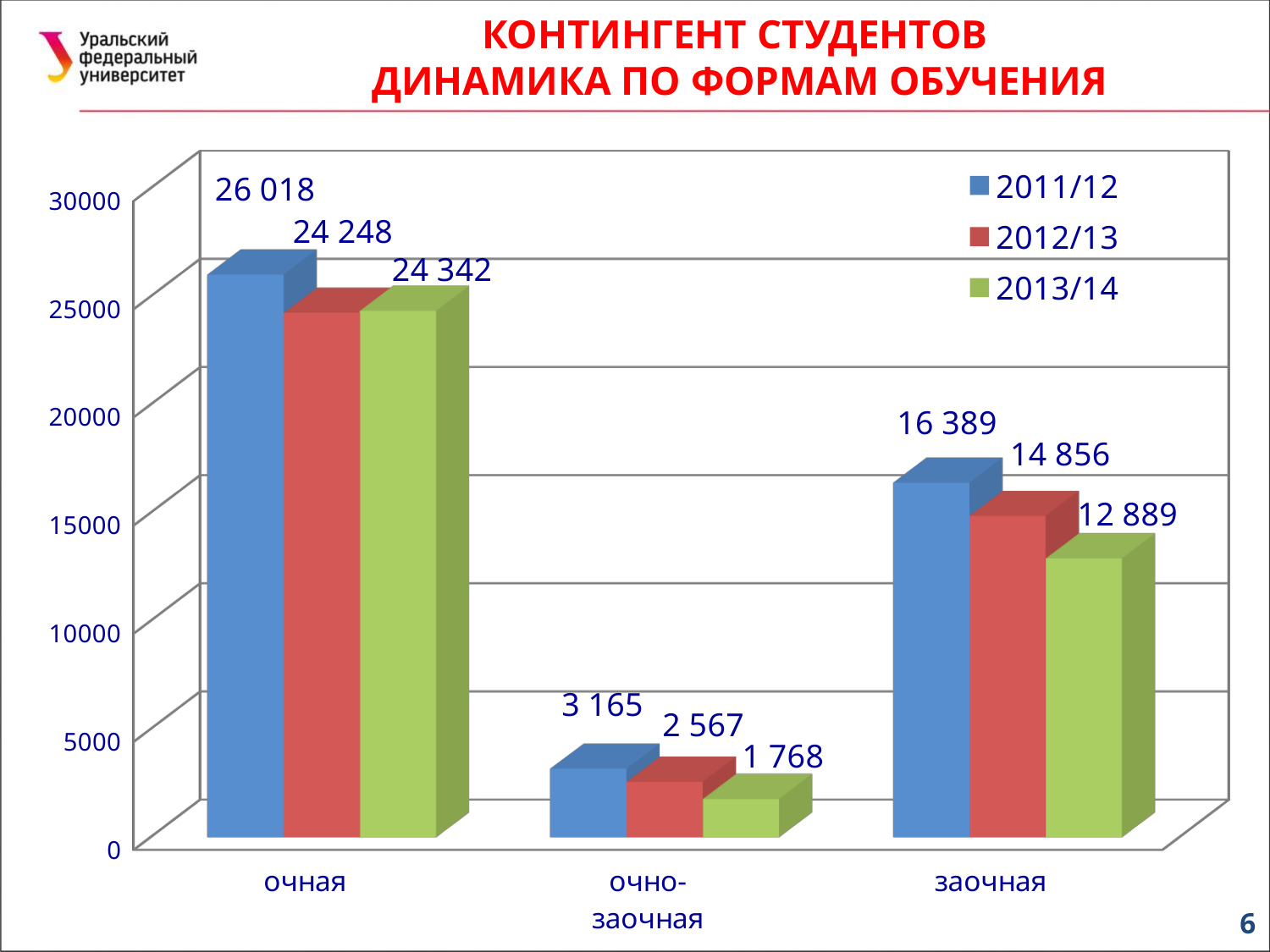
What is the value for очная in 2011/12? 26 018 What is the value for заочная in 2013/14? 12 889 What kind of chart is shown on the slide? bar chart Which is larger for очная: the 2012/13 value or the 2013/14 value? 2013/14 How many series does the legend list? 3 Which category has the lowest value in 2013/14? очно-заочная Do the values for очно-заочная rise or fall from 2011/12 to 2013/14? fall How many categories are shown on the x axis? 3 Which category has the highest value in 2012/13? очная What is the value for очно-заочная in 2012/13? 2 567 Is the value for заочная in 2011/12 greater or less than 15000? greater What is the difference between the 2011/12 and 2013/14 values for заочная? 3 500